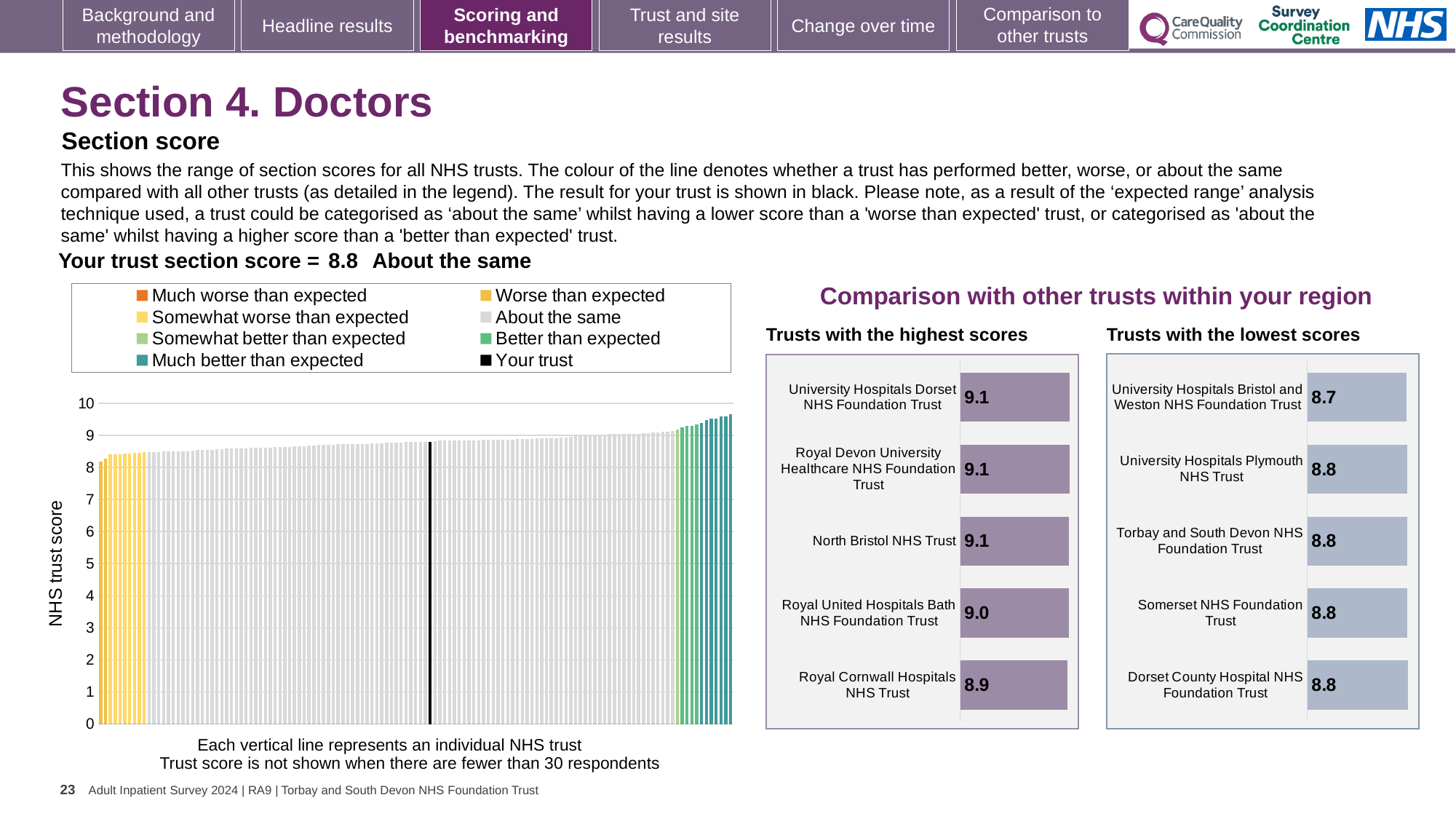
What kind of chart is the large chart on the left showing NHS trust scores? Bar chart In the 'Trusts with the highest scores' chart, what is the difference between the scores of University Hospitals Dorset NHS Foundation Trust and Royal Cornwall Hospitals NHS Trust? 0.2 In the 'Trusts with the highest scores' chart, which trust has the lowest score? Royal Cornwall Hospitals NHS Trust On the left chart, is the value of the black bar (your trust) greater or less than 8? greater In the 'Trusts with the highest scores' chart, what is the score for Royal United Hospitals Bath NHS Foundation Trust? 9.0 In the 'Trusts with the lowest scores' chart, what is the score for Torbay and South Devon NHS Foundation Trust? 8.8 On the left chart, what is the label of the vertical axis? NHS trust score On the left chart, do the bar values rise or fall from left to right? Rise How many entries does the legend above the left chart list? 8 In the 'Trusts with the highest scores' chart, how many trusts are listed? 5 What is the section score for your trust shown on the slide? 8.8 In the 'Trusts with the lowest scores' chart, which trust has the lowest score? University Hospitals Bristol and Weston NHS Foundation Trust